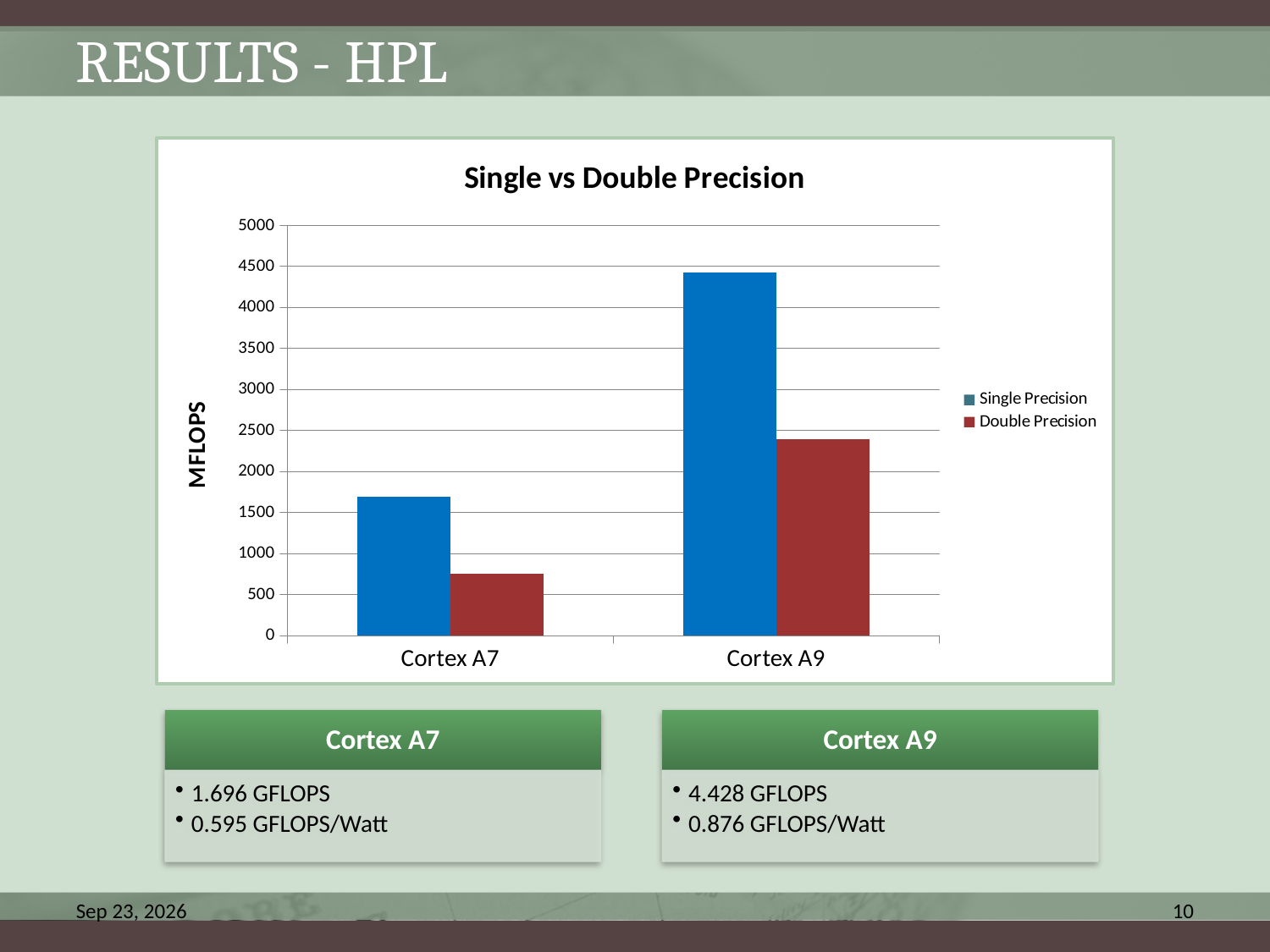
What is the label of the vertical axis of the chart? MFLOPS Is the Double Precision value for Cortex A9 greater or less than 2000? greater Is the Double Precision value for Cortex A7 greater or less than 1000? less How many series does the chart legend list? 2 For Cortex A9, which is larger: the Single Precision value or the Double Precision value? Single Precision What kind of chart is shown on the slide? bar chart Which processor has the highest Single Precision value in the chart? Cortex A9 Is the Single Precision value for Cortex A9 greater or less than 4000? greater What is the title of the chart? Single vs Double Precision How many processor categories are shown on the x axis of the chart? 2 Which processor has the lowest Double Precision value in the chart? Cortex A7